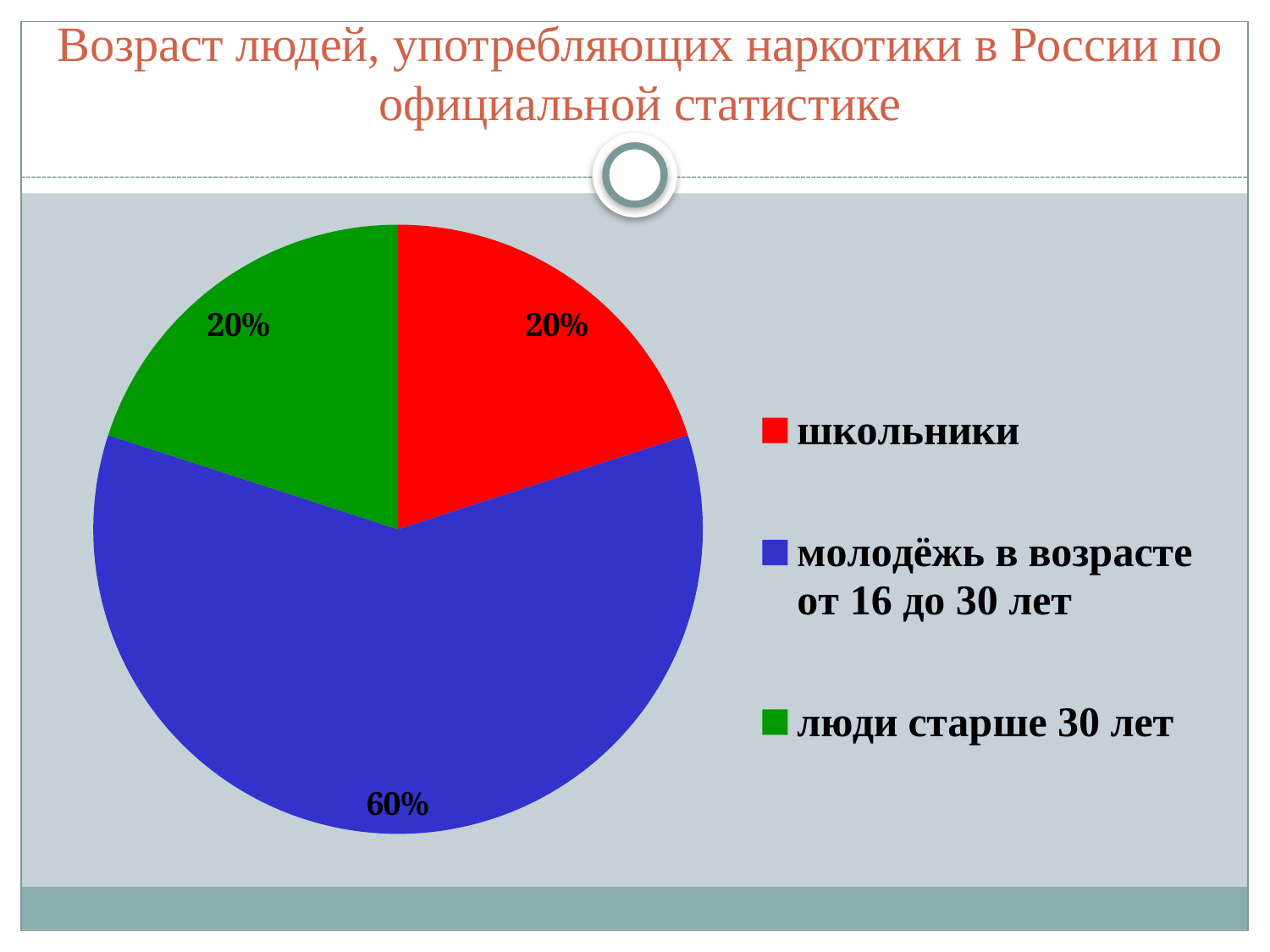
What colour is the slice for школьники? red Is the share for молодёжь в возрасте от 16 до 30 лет greater or less than 50%? greater How many entries does the legend list? 3 Which category has the largest slice of the pie? молодёжь в возрасте от 16 до 30 лет What share of the pie is labelled for люди старше 30 лет? 20% What is the title of the slide? Возраст людей, употребляющих наркотики в России по официальной статистике Which is larger: the share for молодёжь в возрасте от 16 до 30 лет or the share for люди старше 30 лет? молодёжь в возрасте от 16 до 30 лет What kind of chart is shown on the slide? pie chart What share of the pie is labelled for школьники? 20% How many slices does the pie chart have? 3 What is the difference between the share for молодёжь в возрасте от 16 до 30 лет and the share for школьники? 40% What share of the pie is labelled for молодёжь в возрасте от 16 до 30 лет? 60%